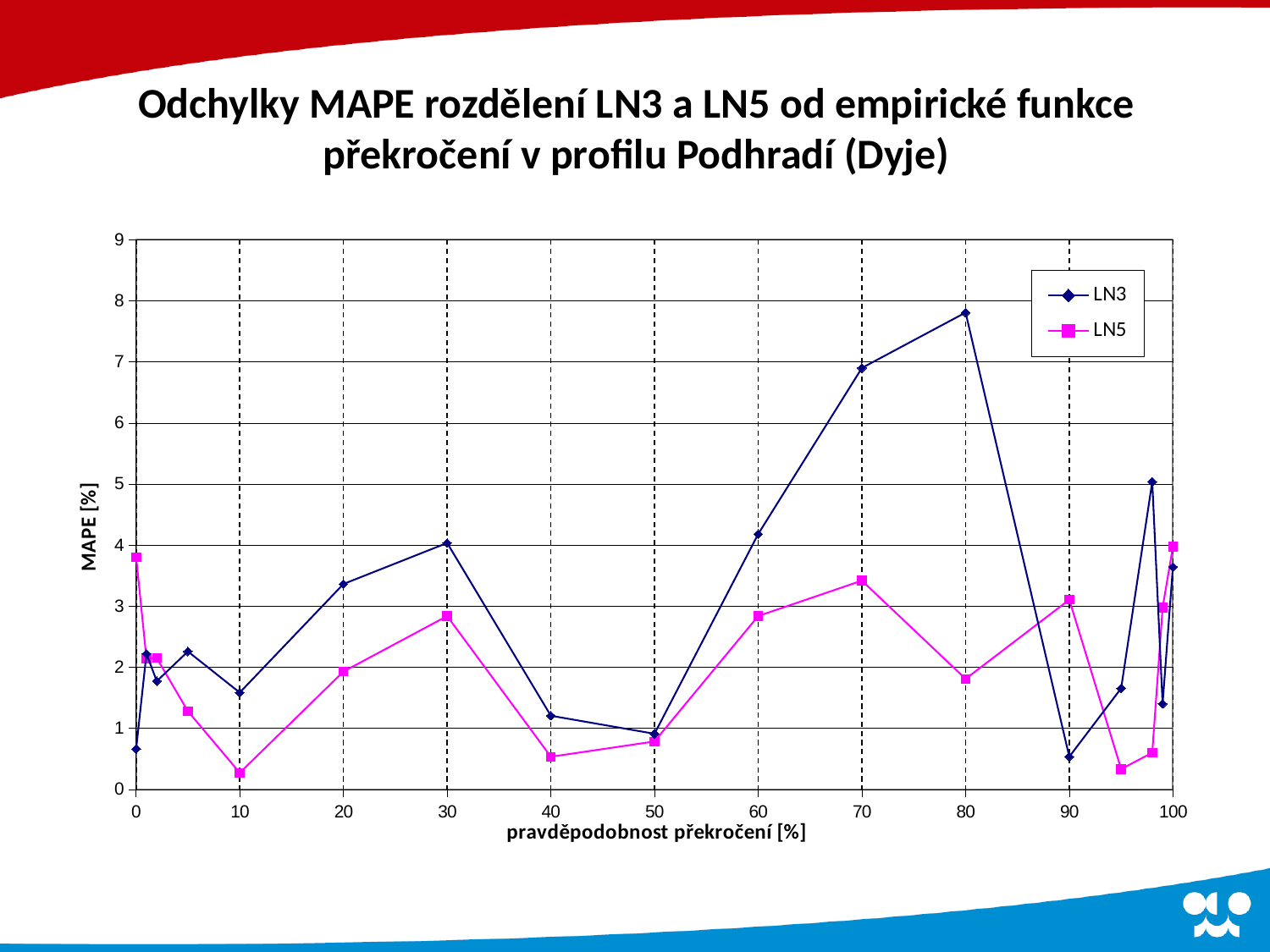
How many series does the legend list? 2 At which value of pravděpodobnost překročení does the LN3 series reach its highest MAPE? 80 At pravděpodobnost překročení 80, which series has the larger MAPE, LN3 or LN5? LN3 Does the LN3 series rise or fall between pravděpodobnost překročení 60 and 80? rise Is the LN3 value at pravděpodobnost překročení 30 greater or less than 3? greater Is the LN3 value at pravděpodobnost překročení 80 greater or less than 7? greater What is the label of the y axis? MAPE [%] What kind of chart is shown on the slide? line chart Is the LN5 value at pravděpodobnost překročení 10 greater or less than 1? less At pravděpodobnost překročení 0, which series has the larger MAPE, LN3 or LN5? LN5 What are the two series named in the legend? LN3 and LN5